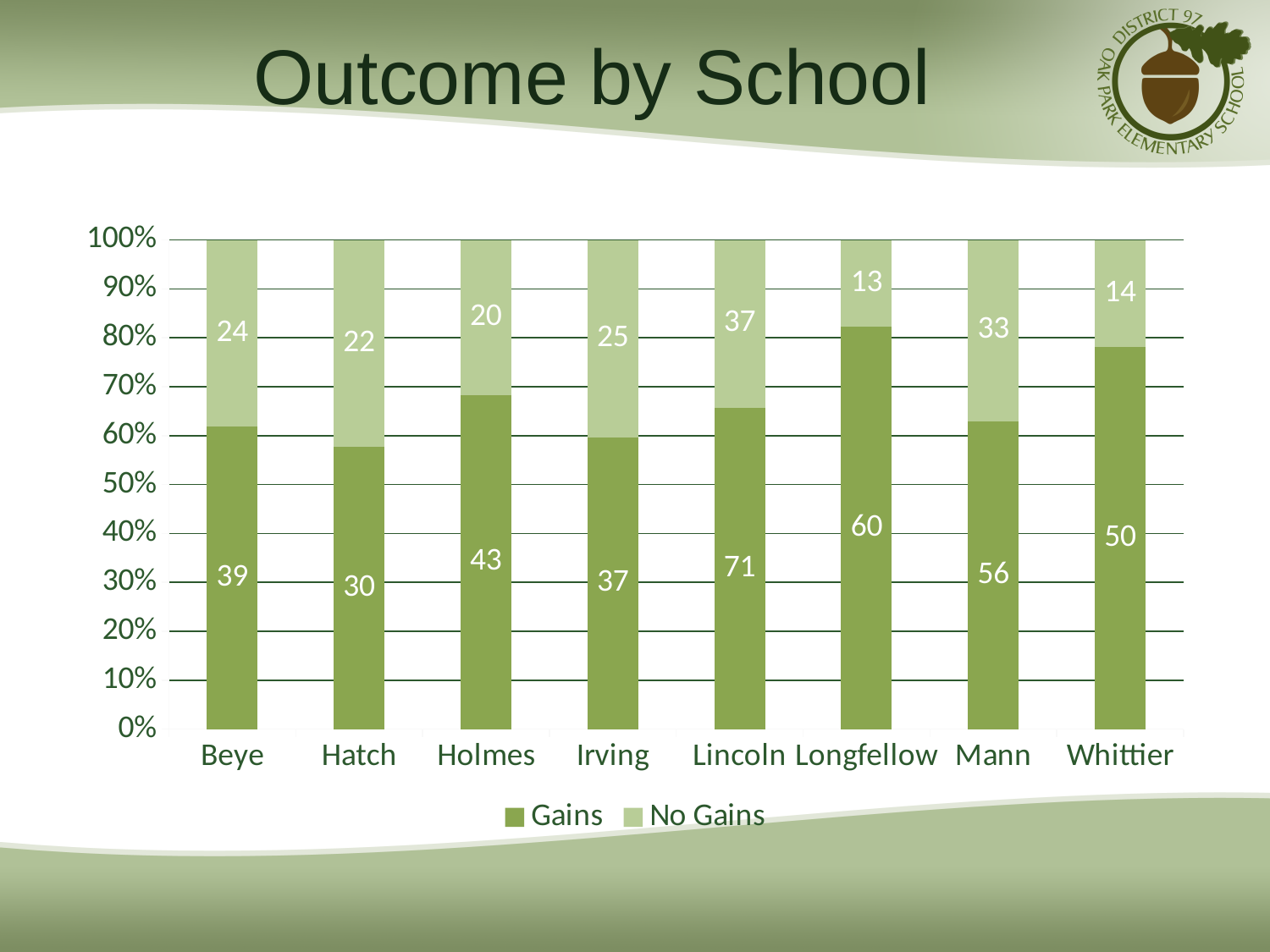
What is the No Gains value for Longfellow? 13 What is the Gains value for Lincoln? 71 What is the Gains value for Hatch? 30 What is the difference between the Gains and No Gains values for Mann? 23 How many schools are shown on the x axis? 8 What is the total of the Gains and No Gains values for Beye? 63 Is the Gains share of the Whittier bar greater or less than 70%? greater How many series does the legend list? 2 Which school has the highest Gains value? Lincoln Which school has the lowest No Gains value? Longfellow Which is larger, the Gains value for Holmes or the Gains value for Irving? Holmes What kind of chart is shown on the slide? Stacked bar chart